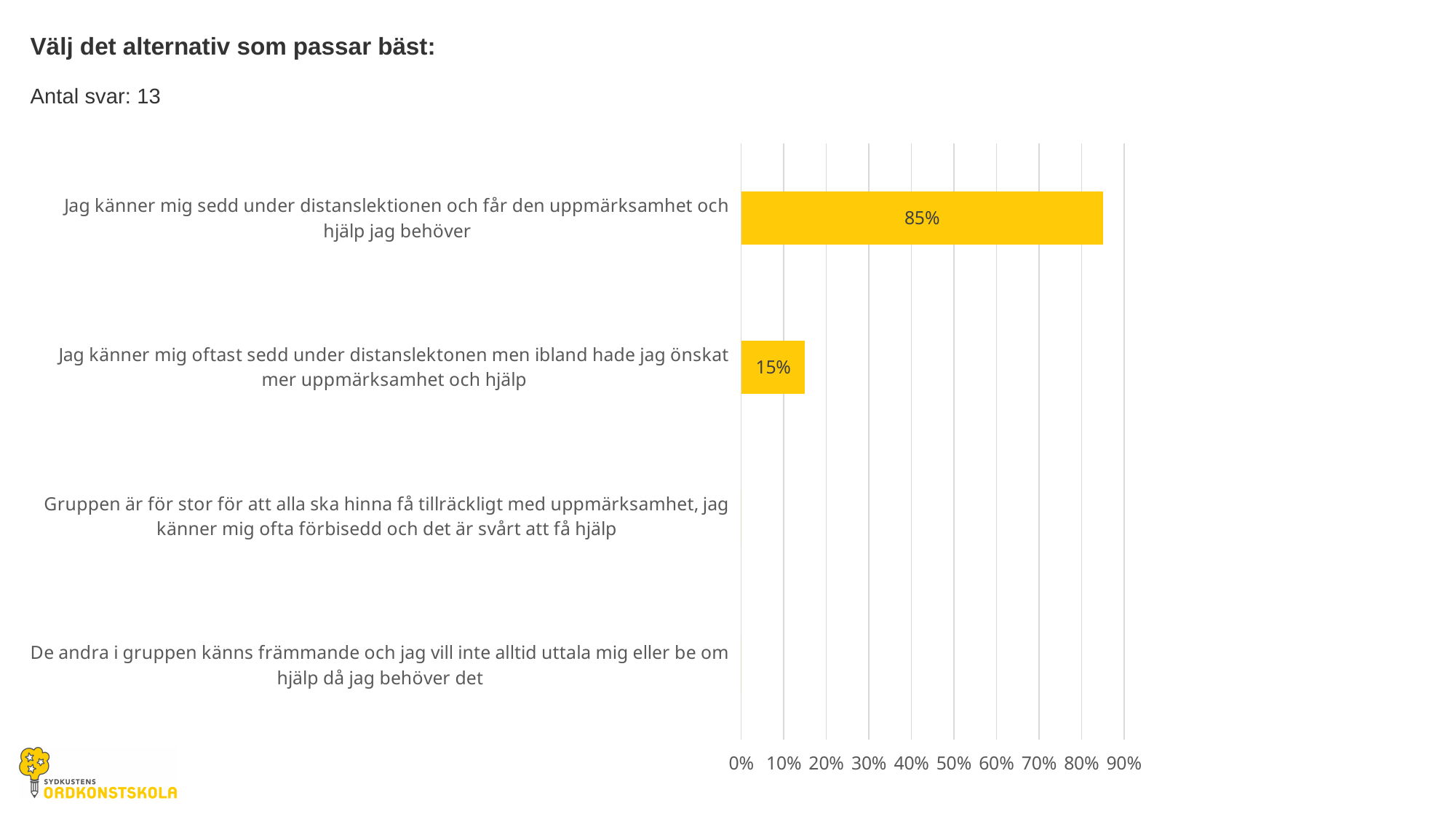
What kind of chart is shown on the slide? Bar chart What is the difference in percentage points between the top option (85%) and the second option (15%)? 70 percentage points How many answer options are shown in the chart? 4 Is the value for "Jag känner mig sedd under distanslektionen och får den uppmärksamhet och hjälp jag behöver" greater or less than 80%? greater Is the value for "Gruppen är för stor för att alla ska hinna få tillräckligt med uppmärksamhet..." greater or less than 10%? less Which answer option has the highest percentage? Jag känner mig sedd under distanslektionen och får den uppmärksamhet och hjälp jag behöver Which has a larger share: "Jag känner mig sedd under distanslektionen..." or "Jag känner mig oftast sedd under distanslektonen..."? Jag känner mig sedd under distanslektionen och får den uppmärksamhet och hjälp jag behöver What percentage of respondents chose "Jag känner mig oftast sedd under distanslektonen men ibland hade jag önskat mer uppmärksamhet och hjälp"? 15% What percentage of respondents chose "Jag känner mig sedd under distanslektionen och får den uppmärksamhet och hjälp jag behöver"? 85% How many responses (Antal svar) does the slide report? 13 What is the highest value shown on the x axis? 90%